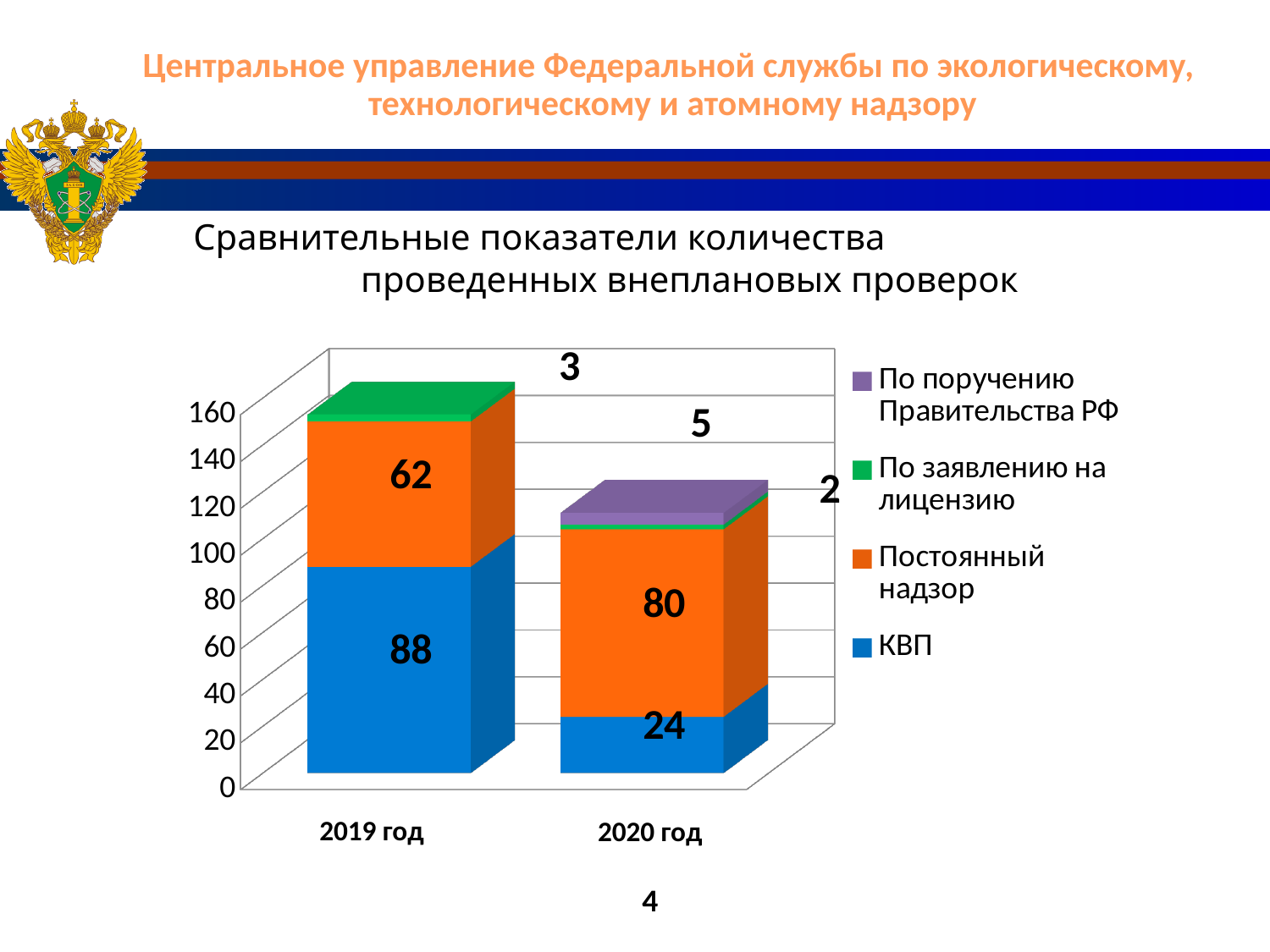
How many series does the legend list? 4 What is the difference between the КВП values for 2019 год and 2020 год? 64 Is the total height of the 2020 год bar greater or less than 120? less What is the value of КВП for 2019 год? 88 Does the КВП value rise or fall from 2019 год to 2020 год? Fall Is the total height of the 2019 год bar greater or less than 140? greater What is the value of Постоянный надзор for 2020 год? 80 What is the value of Постоянный надзор for 2019 год? 62 How many categories (years) are shown on the x axis? 2 What kind of chart is shown on the slide? Stacked bar chart Which year has the larger Постоянный надзор value, 2019 год or 2020 год? 2020 год What is the value of КВП for 2020 год? 24